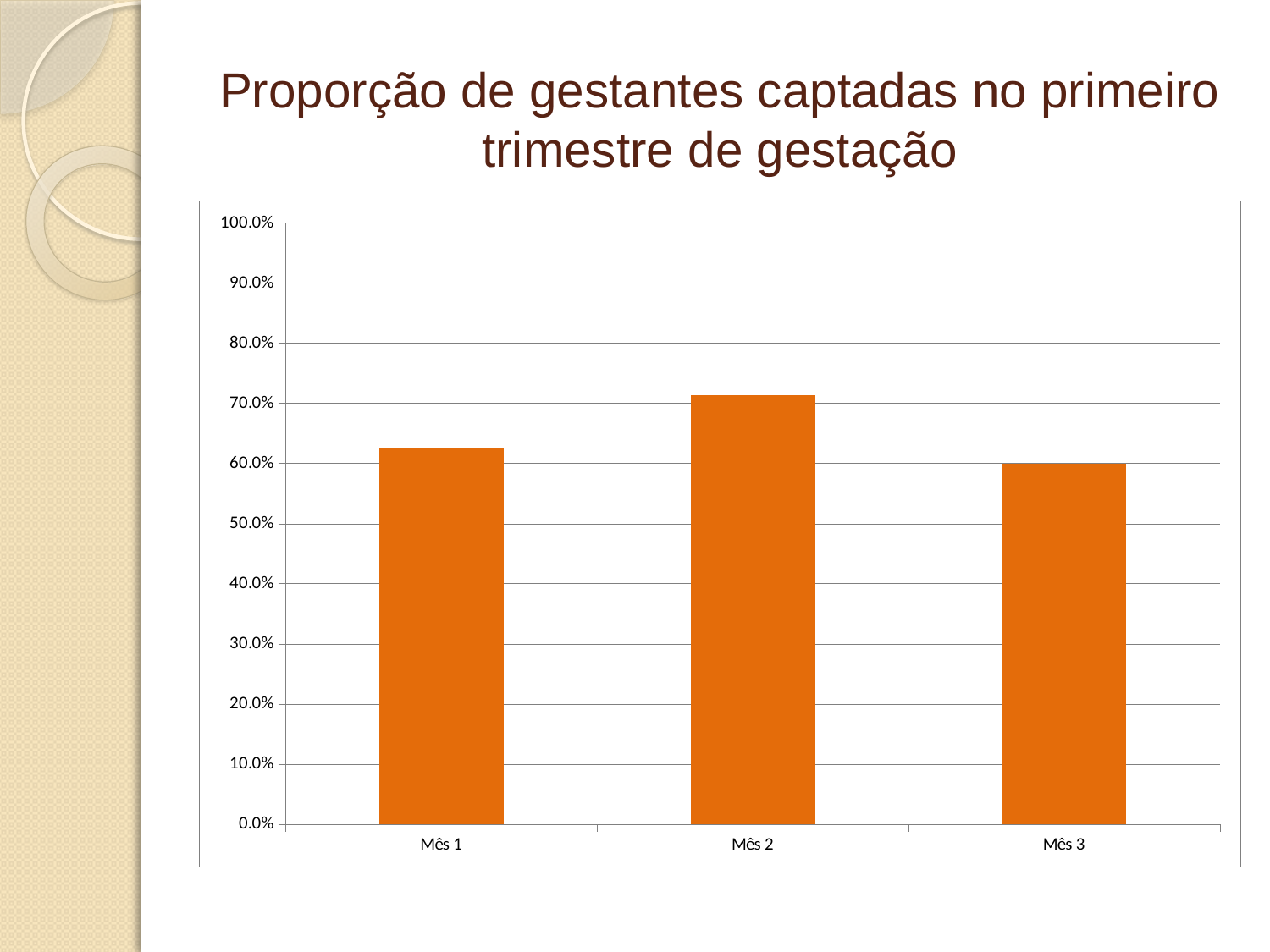
Is the value for Mês 3 greater or less than 70.0%? less Is the value for Mês 2 greater or less than 80.0%? less Is the value for Mês 2 greater or less than 70.0%? greater Which is larger, the value for Mês 1 or the value for Mês 3? Mês 1 How many categories are plotted on the x axis? 3 What is the title of the chart on the slide? Proporção de gestantes captadas no primeiro trimestre de gestação Which month has the lowest proportion? Mês 3 Which is larger, the value for Mês 2 or the value for Mês 1? Mês 2 What kind of chart is shown on the slide? Bar chart Which month has the highest proportion? Mês 2